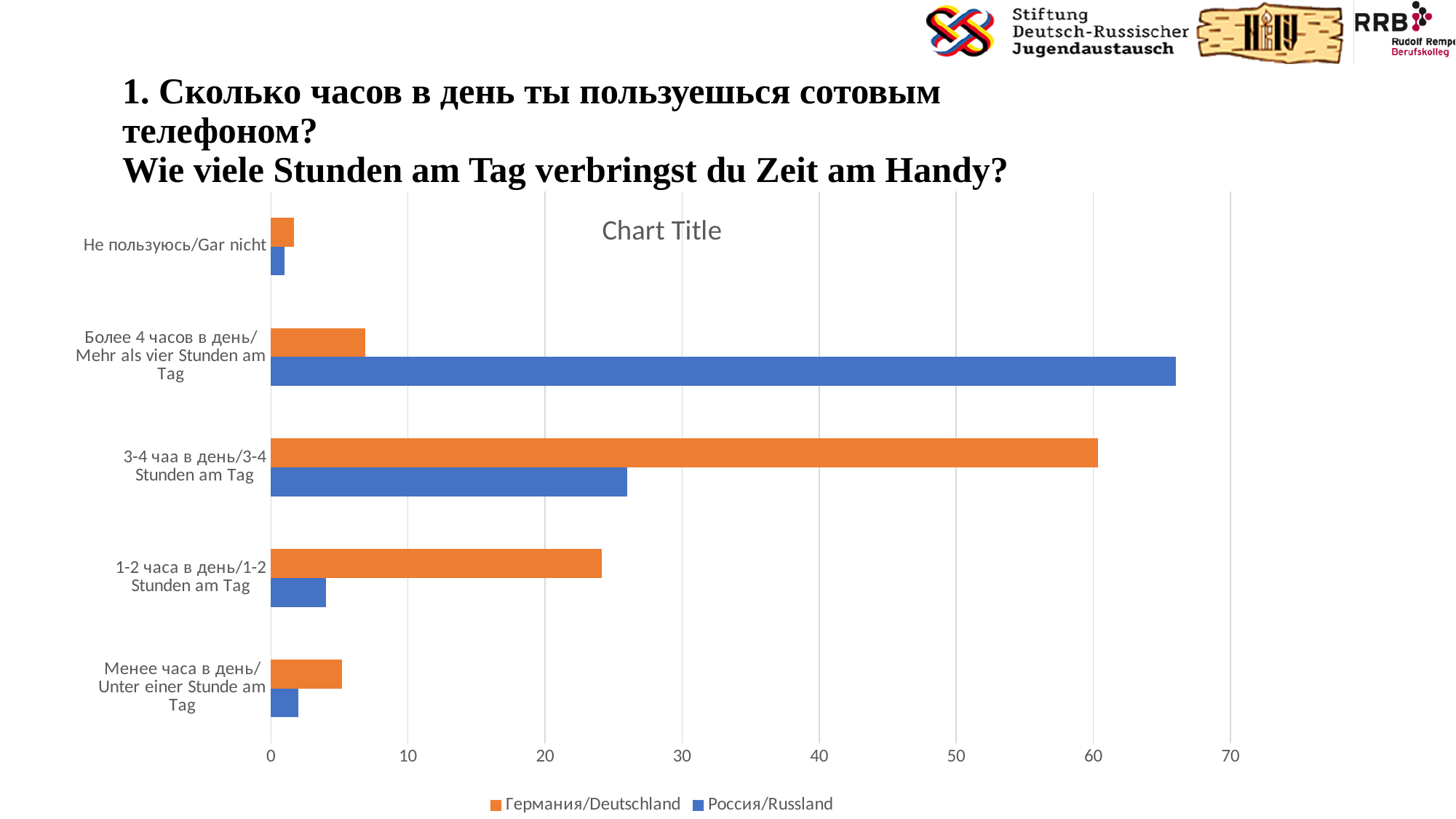
How many categories are shown on the chart? 5 Is the value for Германия/Deutschland in the category 1-2 Stunden am Tag greater or less than 20? greater Which category has the highest value for Россия/Russland? Более 4 часов в день/Mehr als vier Stunden am Tag How many series does the legend list? 2 Which category has the lowest value for Германия/Deutschland? Не пользуюсь/Gar nicht What kind of chart is shown on the slide? bar chart Is the value for Россия/Russland in the category 1-2 Stunden am Tag greater or less than 10? less For the category Mehr als vier Stunden am Tag, which series has the larger value, Германия/Deutschland or Россия/Russland? Россия/Russland Is the value for Россия/Russland in the category Mehr als vier Stunden am Tag greater or less than 60? greater Which colour represents the series Россия/Russland in the chart? blue Which category has the highest value for Германия/Deutschland? 3-4 чаа в день/3-4 Stunden am Tag For the category 3-4 Stunden am Tag, which series has the larger value, Германия/Deutschland or Россия/Russland? Германия/Deutschland